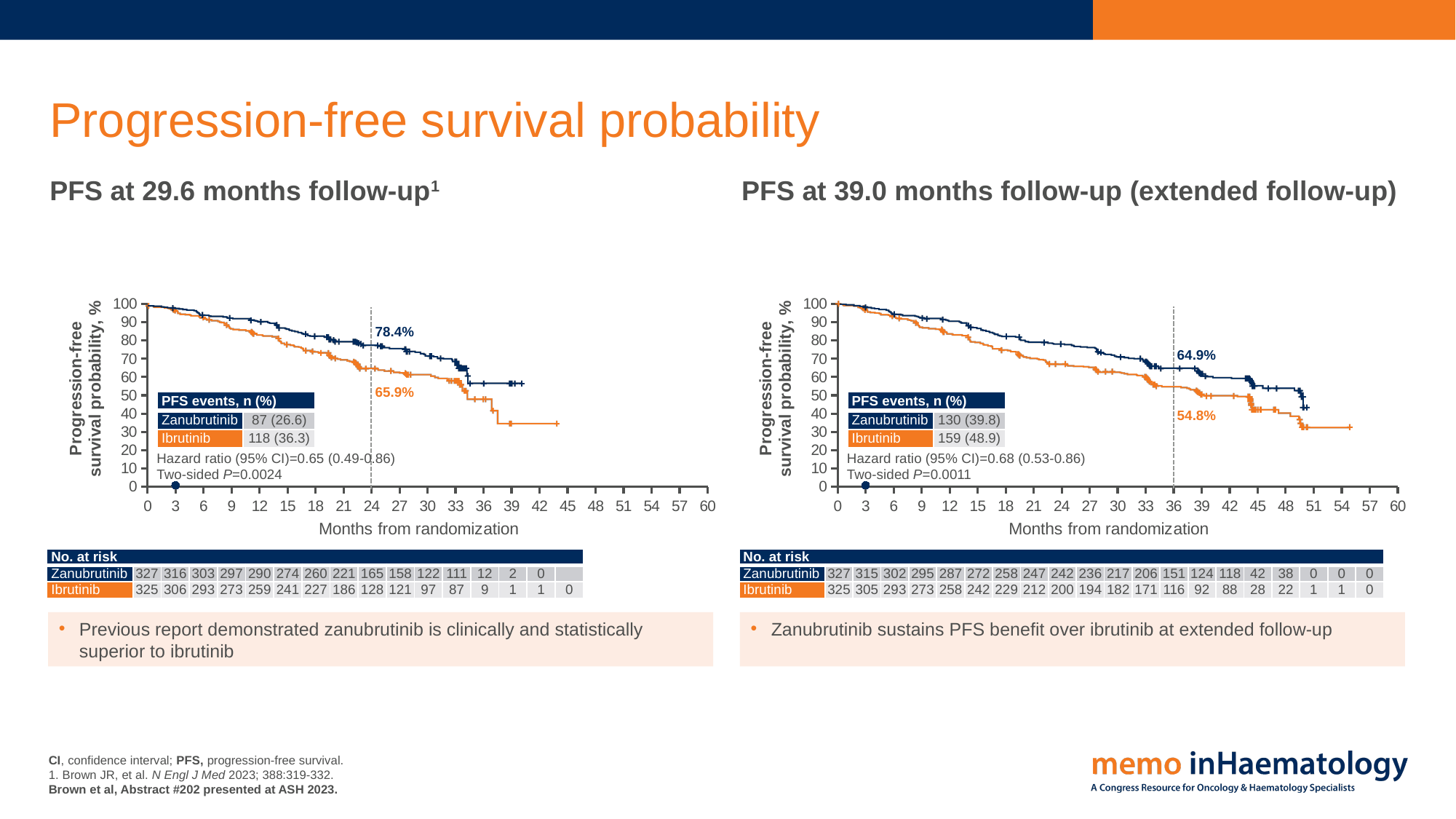
In the left chart (PFS at 29.6 months follow-up), how many PFS events are reported for ibrutinib? 118 (36.3) In the right chart (PFS at 39.0 months follow-up), what is the labelled progression-free survival probability for zanubrutinib at the dashed line at 36 months? 64.9% What kind of chart is shown on the left (PFS at 29.6 months follow-up)? Line chart (Kaplan-Meier survival curve) In the right chart (PFS at 39.0 months follow-up), which arm has the higher labelled PFS probability at 36 months, zanubrutinib or ibrutinib? Zanubrutinib In the right chart (PFS at 39.0 months follow-up), what is the labelled progression-free survival probability for ibrutinib at the dashed line at 36 months? 54.8% In the left chart (PFS at 29.6 months follow-up), what is the labelled progression-free survival probability for ibrutinib at the dashed line at 24 months? 65.9% How many treatment arms (series) are plotted in the right chart (PFS at 39.0 months follow-up)? 2 In the right chart (PFS at 39.0 months follow-up), what is the difference between the labelled zanubrutinib and ibrutinib values at 36 months? 10.1 percentage points In the left chart (PFS at 29.6 months follow-up), what is the labelled progression-free survival probability for zanubrutinib at the dashed line at 24 months? 78.4% In the left chart (PFS at 29.6 months follow-up), what is the difference between the labelled zanubrutinib and ibrutinib values at 24 months? 12.5 percentage points In the right chart (PFS at 39.0 months follow-up), how many PFS events are reported for zanubrutinib? 130 (39.8) In the right chart (PFS at 39.0 months follow-up), how many zanubrutinib patients are at risk at 0 months according to the No. at risk table? 327